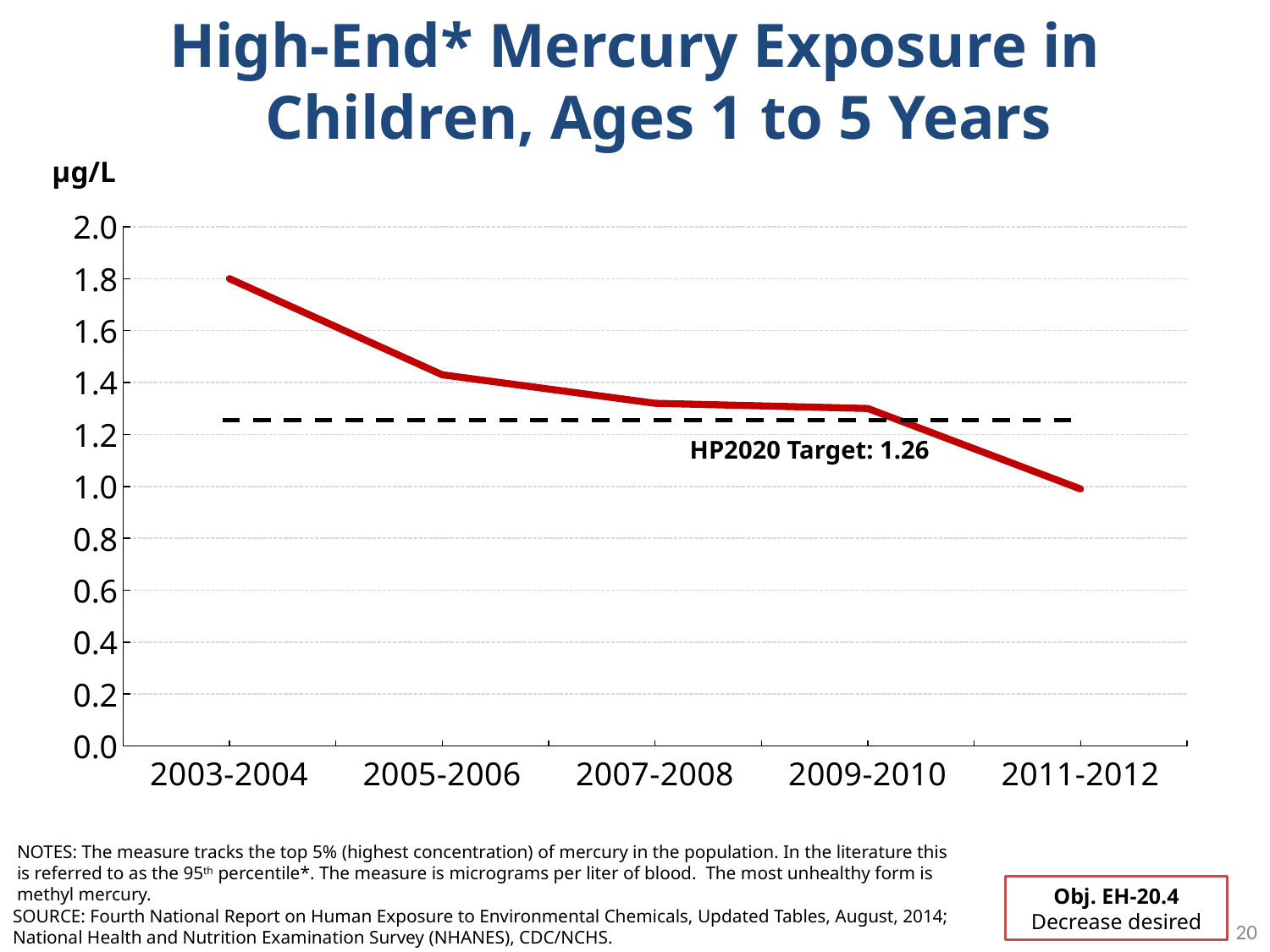
Is the value for 2005-2006 greater or less than 1.6? less What unit is shown on the y axis of the chart? µg/L Which is larger, the value for 2003-2004 or the value for 2011-2012? 2003-2004 Which survey period has the highest high-end mercury exposure value? 2003-2004 Which survey period has the lowest high-end mercury exposure value? 2011-2012 Is the value for 2003-2004 greater or less than 1.6? greater Is the value for 2007-2008 greater or less than 1.2? greater What is the HP2020 Target value shown on the chart? 1.26 What kind of chart is shown on the slide? line chart Do the plotted values rise or fall from 2003-2004 to 2011-2012? fall How many survey periods are plotted along the x axis? 5